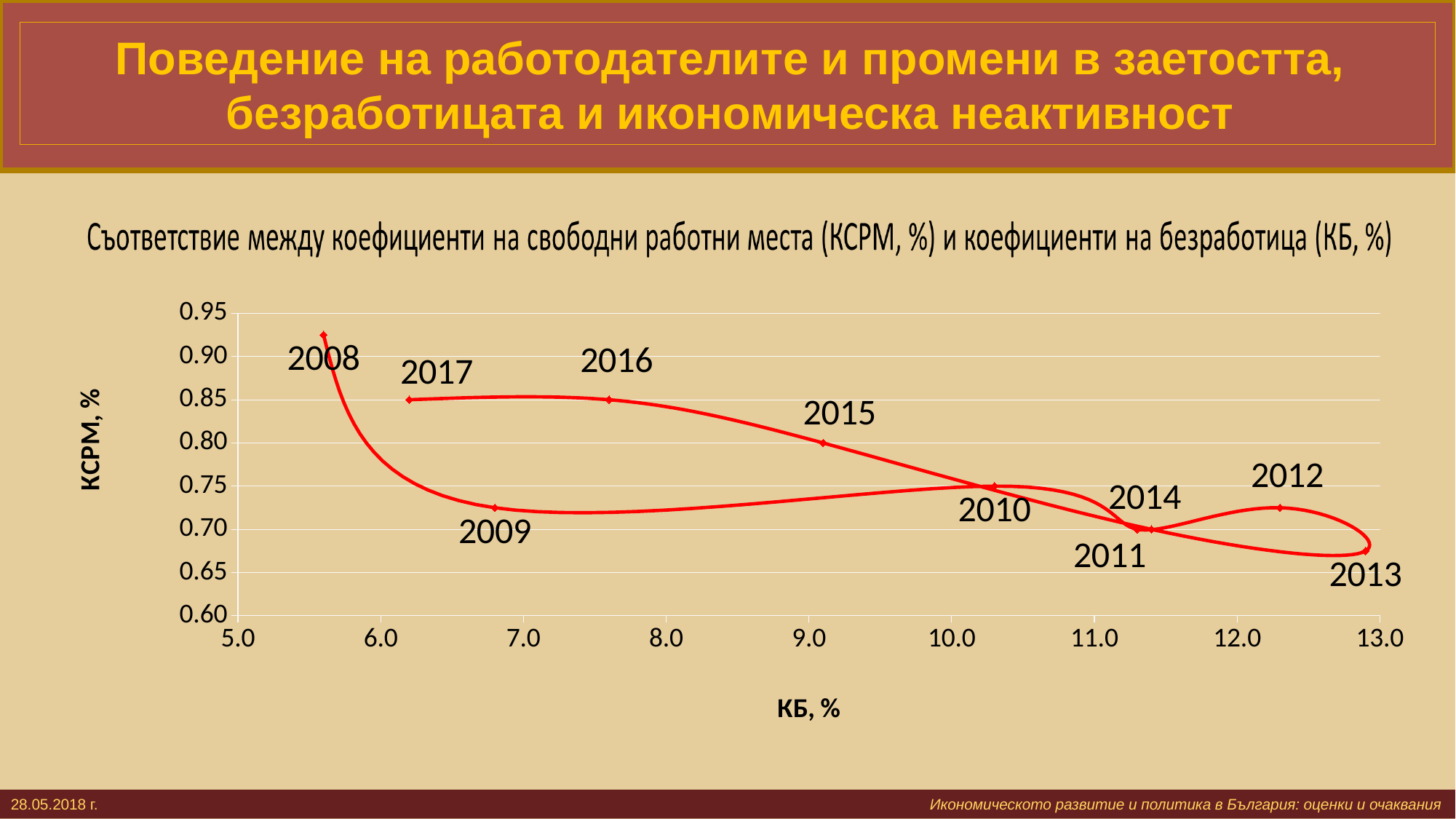
What is the label of the horizontal axis? КБ, % Is the КБ value for 2013 greater or less than 12.0? greater Which year has the highest КСРМ value on the chart? 2008 Which year has the highest КБ value on the chart? 2013 Which year has the higher КСРМ value, 2016 or 2009? 2016 What kind of chart is shown on the slide? line chart How many year-labelled data points are plotted on the chart? 10 Is the КСРМ value for 2009 greater or less than 0.75? less Is the КСРМ value for 2008 greater or less than 0.90? greater Which year has the lowest КСРМ value on the chart? 2013 What is the КСРМ value for 2015? 0.80 Which year has the lowest КБ value on the chart? 2008